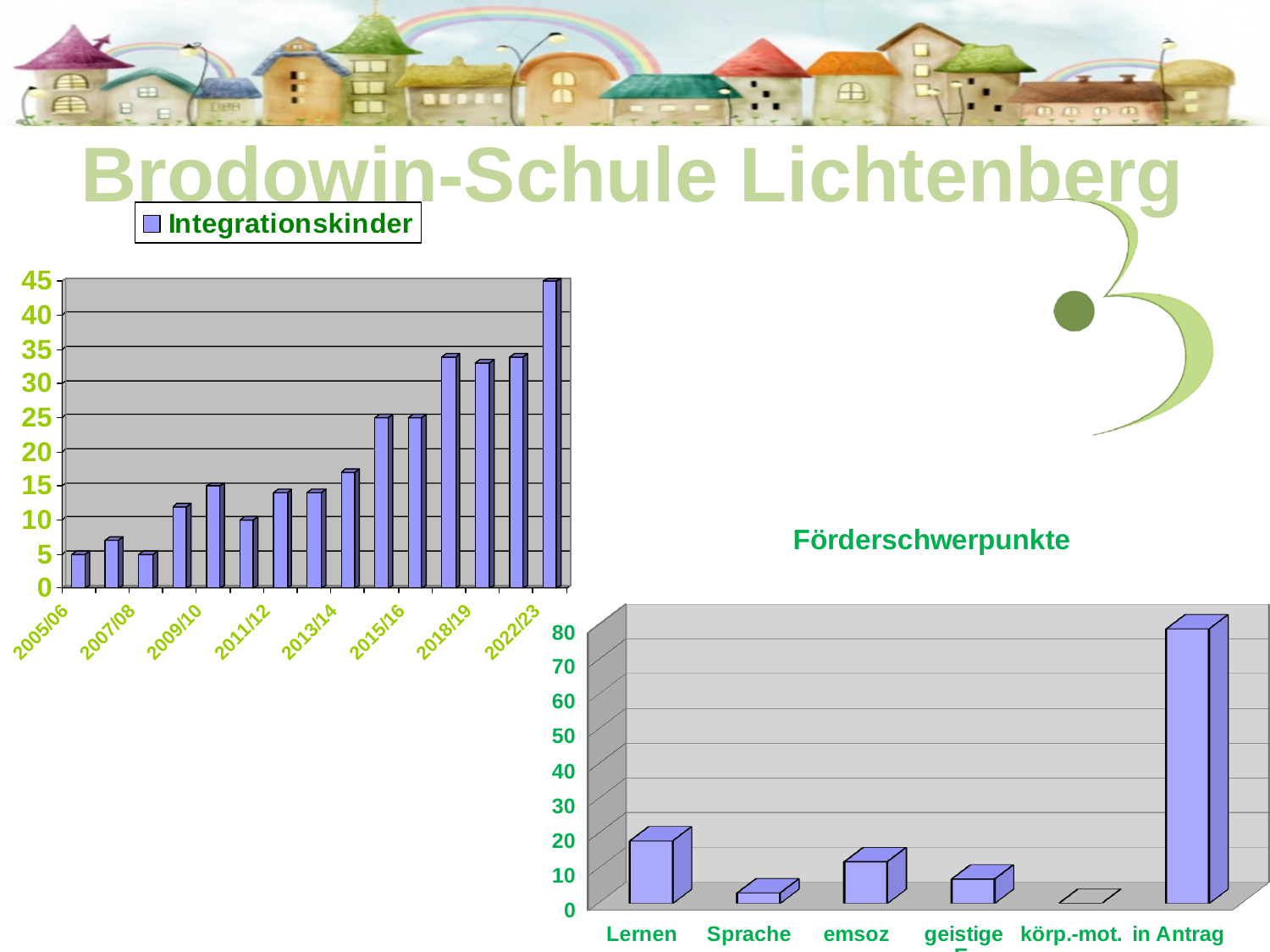
In the Förderschwerpunkte chart, is the value for in Antrag greater or less than 70? greater How many series does the legend of the Integrationskinder chart list? 1 How many categories are shown on the x axis of the Förderschwerpunkte chart? 6 In the Förderschwerpunkte chart, which category has the highest value? in Antrag In the Integrationskinder chart, which school year has the highest value? 2022/23 In the Integrationskinder chart, is the value for 2022/23 greater or less than 40? greater In the Förderschwerpunkte chart, which category has the lowest value? körp.-mot. What kind of chart is the Integrationskinder chart on the left? bar chart In the Integrationskinder chart, is the value for 2018/19 greater or less than 30? greater In the Integrationskinder chart, do the values generally rise or fall from 2005/06 to 2022/23? rise In the Förderschwerpunkte chart, which is larger, Lernen or emsoz? Lernen